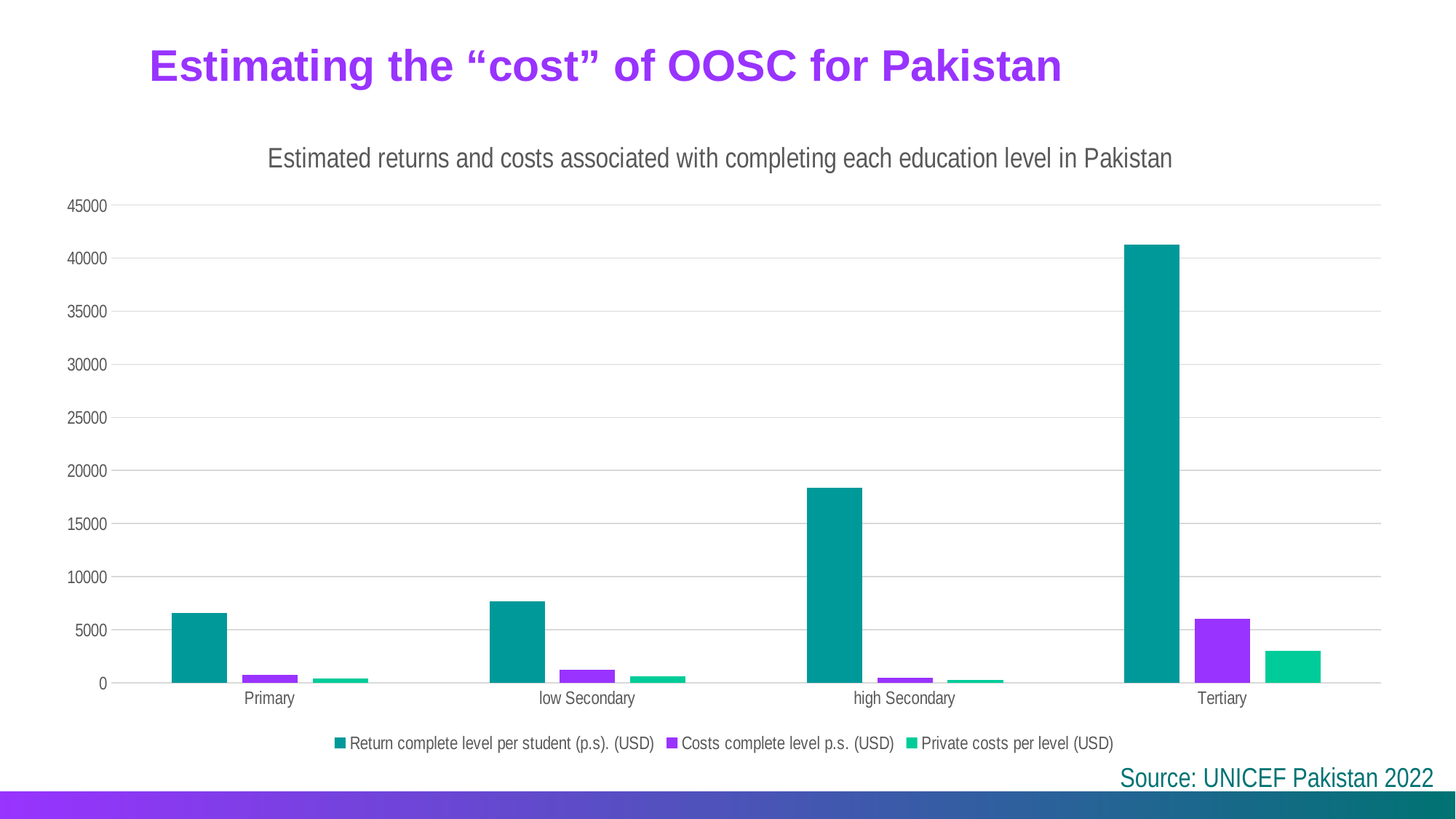
How many series does the legend list? 3 Do the values for Return complete level per student (p.s.) (USD) rise or fall from Primary to Tertiary? rise What is the title of the chart? Estimated returns and costs associated with completing each education level in Pakistan Is the value for Return complete level per student (p.s.) (USD) at high Secondary greater or less than 20000? less Which education level has the highest value for Return complete level per student (p.s.) (USD)? Tertiary What kind of chart is shown on the slide? bar chart Which is larger at Tertiary: Costs complete level p.s. (USD) or Private costs per level (USD)? Costs complete level p.s. (USD) Is the value for Return complete level per student (p.s.) (USD) at Primary greater or less than 5000? greater Which education level has the highest value for Costs complete level p.s. (USD)? Tertiary How many education levels are shown on the x axis? 4 Which education level has the lowest value for Return complete level per student (p.s.) (USD)? Primary Is the value for Return complete level per student (p.s.) (USD) at Tertiary greater or less than 40000? greater